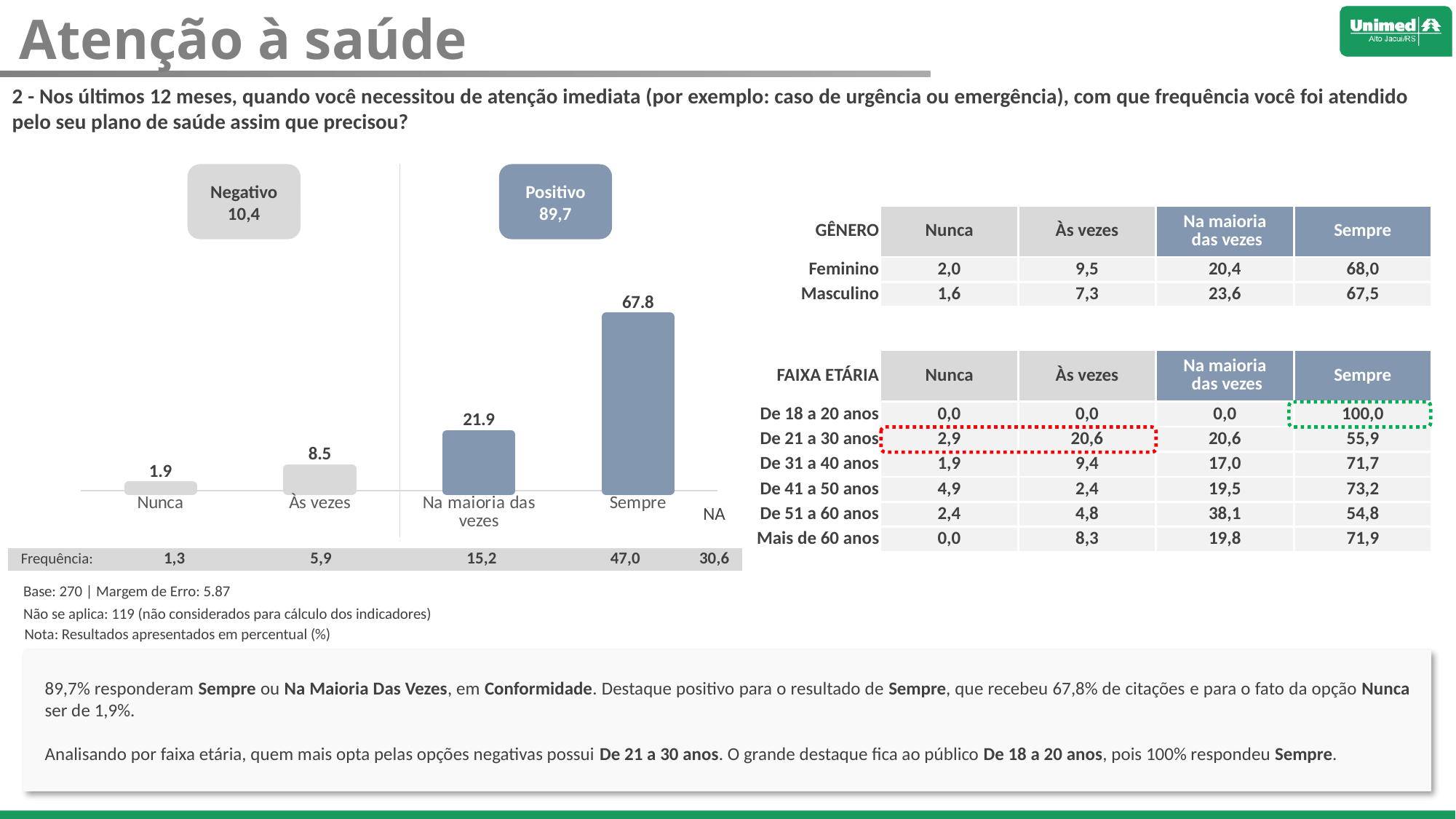
What is the value of the bar for Nunca? 1.9 What total is shown in the Positivo box above the blue bars? 89,7 Which category has the lowest bar in the chart? Nunca Which category has the highest bar in the chart? Sempre What type of chart is shown on the slide? bar chart How many bars are plotted in the chart? 4 What is the difference between the values for Sempre and Na maioria das vezes? 45.9 What is the value of the bar for Às vezes? 8.5 Do the bar values rise or fall from left to right across the chart? rise Which is larger, the value for Às vezes or the value for Nunca? Às vezes What is the value of the bar for Sempre? 67.8 What is the value of the bar for Na maioria das vezes? 21.9